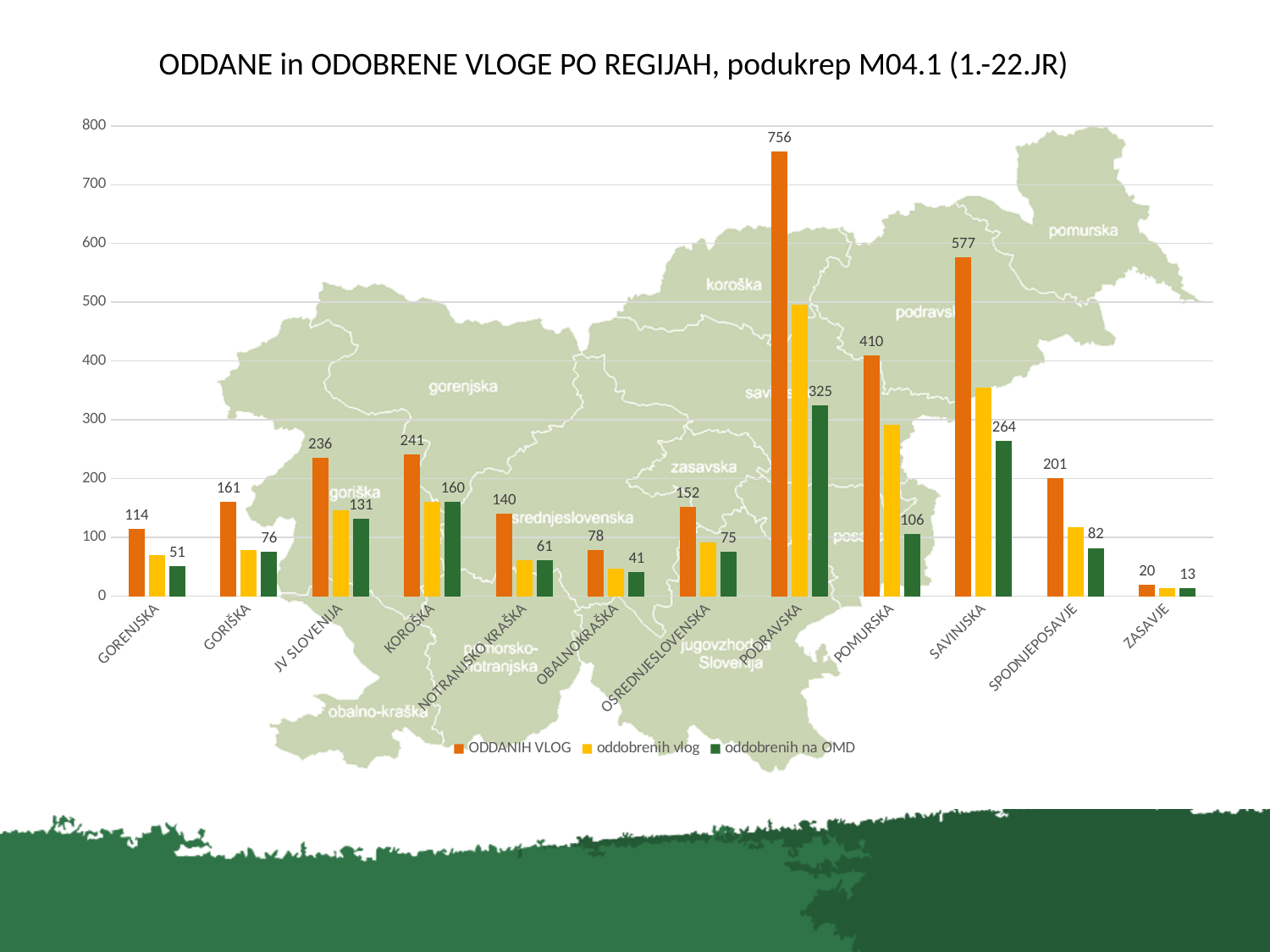
How many regions are shown on the x axis? 12 Which region has the highest value for ODDANIH VLOG? PODRAVSKA What colour represents the ODDANIH VLOG series? orange Is the value of oddobrenih vlog for PODRAVSKA greater or less than 400? greater What kind of chart is shown on the slide? bar chart How many series does the legend list? 3 Which has a larger ODDANIH VLOG value, KOROŠKA or JV SLOVENIJA? KOROŠKA What is the value of oddobrenih na OMD for SAVINJSKA? 264 Which region has the lowest value for oddobrenih na OMD? ZASAVJE What is the value of ODDANIH VLOG for PODRAVSKA? 756 What is the difference between the ODDANIH VLOG values for PODRAVSKA and SAVINJSKA? 179 What is the difference between ODDANIH VLOG and oddobrenih na OMD for GORENJSKA? 63